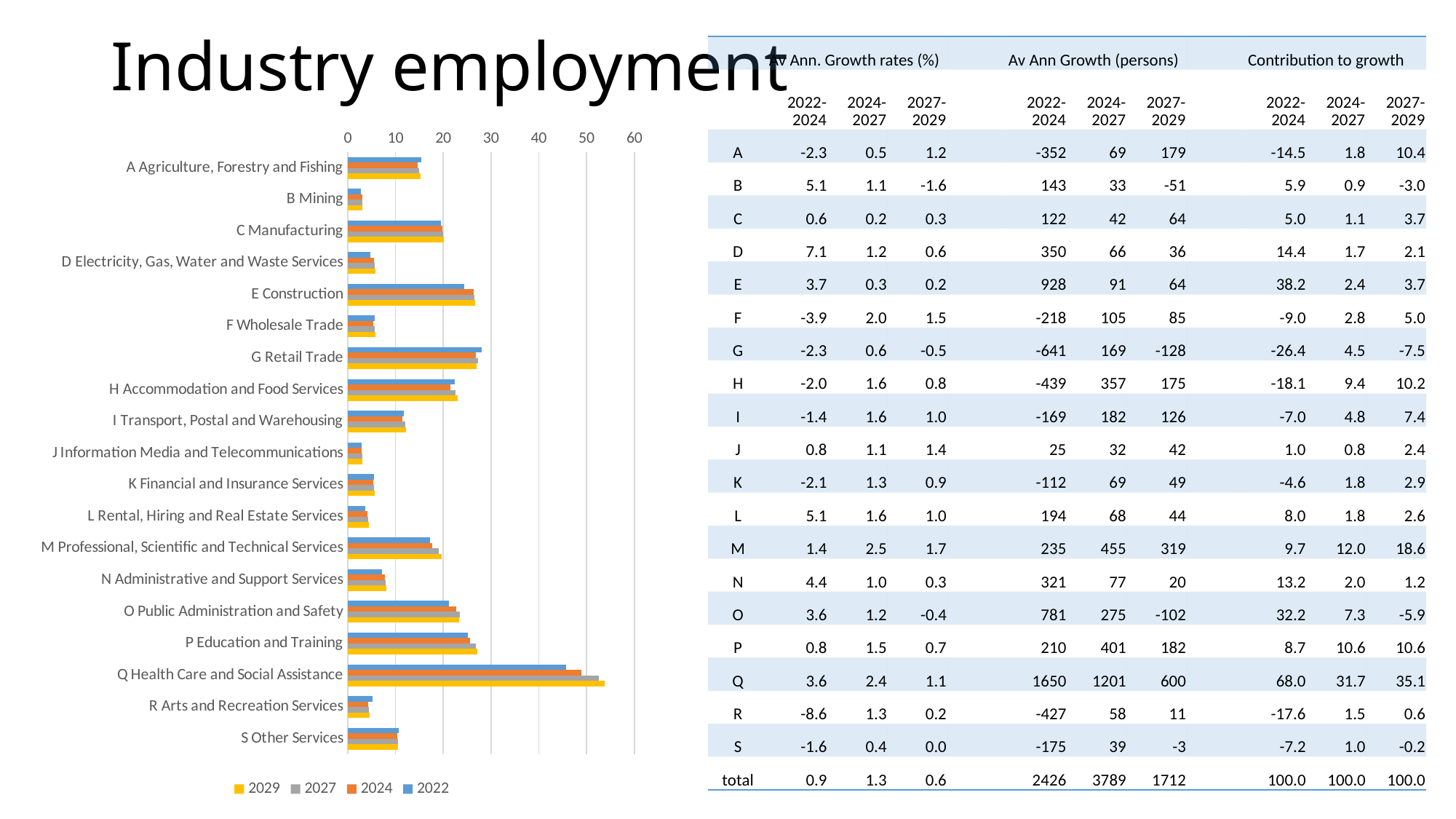
For Q Health Care and Social Assistance, do the values rise or fall from 2022 to 2029? rise Which industry has the longest bars in the chart? Q Health Care and Social Assistance How many industry categories are plotted in the bar chart? 19 Is the 2022 value for Q Health Care and Social Assistance greater or less than 40? greater How many series does the chart legend list? 4 Is the 2022 value for E Construction greater or less than 30? less Is the 2022 value for A Agriculture, Forestry and Fishing greater or less than 10? greater What kind of chart is shown on the slide? bar chart Which has the larger 2022 value, E Construction or F Wholesale Trade? E Construction Which colour represents the 2029 series in the chart legend? yellow Which has the larger 2029 value, Q Health Care and Social Assistance or P Education and Training? Q Health Care and Social Assistance